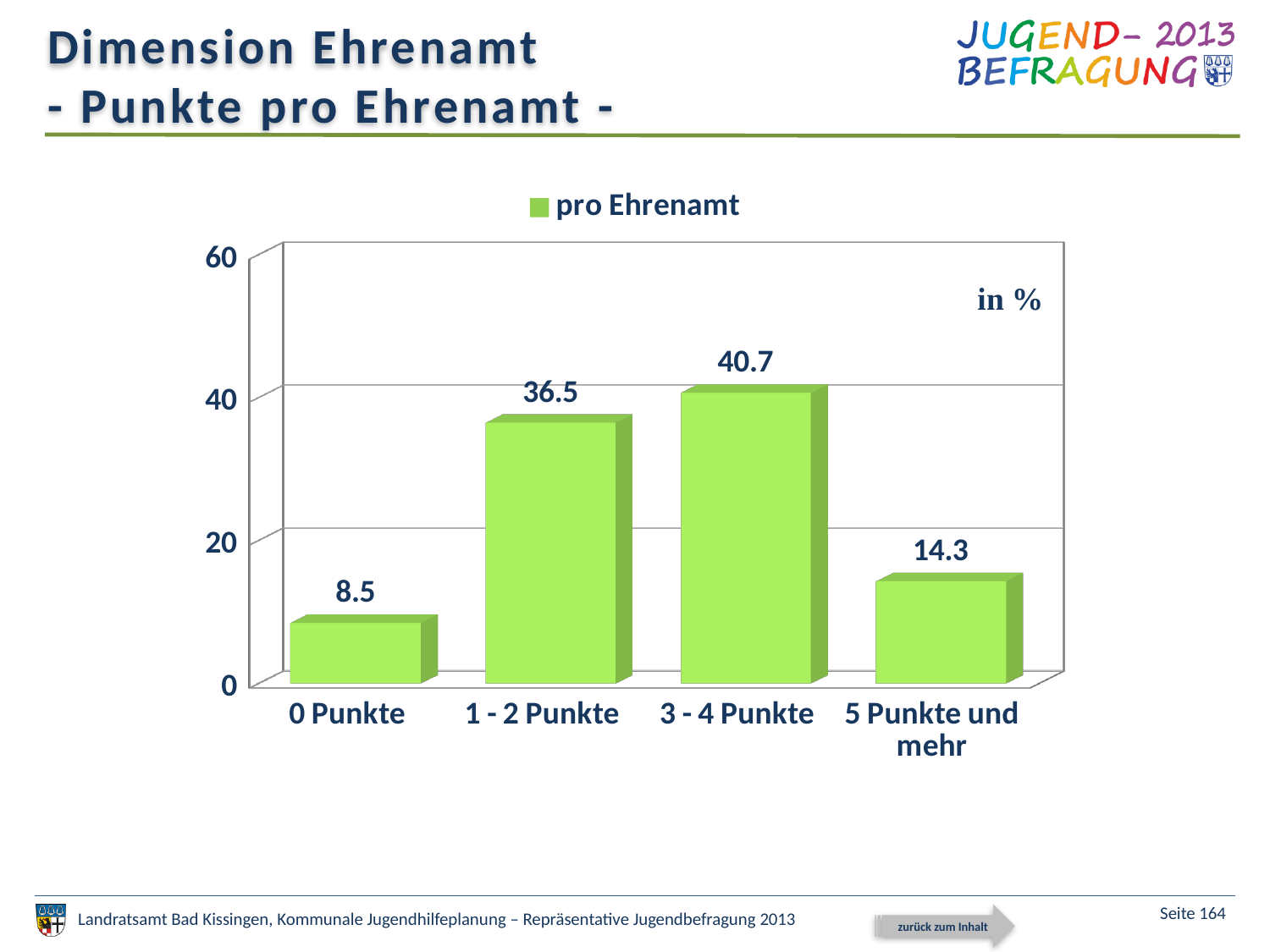
How many categories are shown on the x axis? 4 What is the value for 1 - 2 Punkte? 36.5 What is the value for 3 - 4 Punkte? 40.7 Which category has the lowest value? 0 Punkte What kind of chart is shown on the slide? bar chart What is the value for 5 Punkte und mehr? 14.3 Is the value for 1 - 2 Punkte greater or less than 40? less What is the value for 0 Punkte? 8.5 Which category has the highest value? 3 - 4 Punkte What is the name of the series shown in the legend? pro Ehrenamt Which is larger, the value for 5 Punkte und mehr or the value for 0 Punkte? 5 Punkte und mehr What is the difference between the values for 3 - 4 Punkte and 1 - 2 Punkte? 4.2